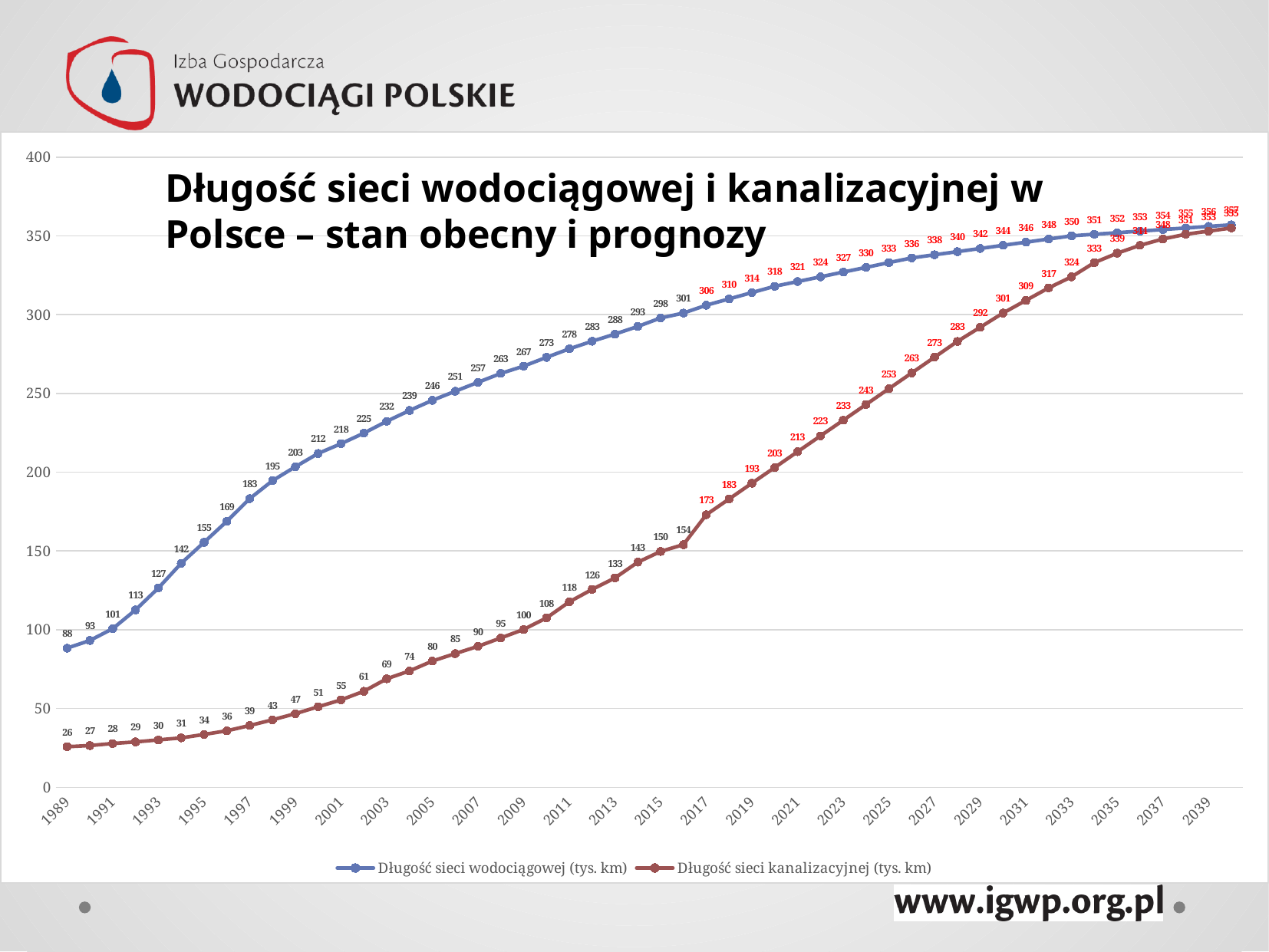
Do the values of Długość sieci kanalizacyjnej rise or fall from 1989 to 2039? rise What is the value of Długość sieci kanalizacyjnej (tys. km) in 1989? 26 What is the value of Długość sieci kanalizacyjnej (tys. km) in 2009? 100 In 2017, which series has the larger value: Długość sieci wodociągowej or Długość sieci kanalizacyjnej? Długość sieci wodociągowej Is the value of Długość sieci wodociągowej in 2039 greater or less than 350? greater How many series does the legend list? 2 In which year is Długość sieci kanalizacyjnej (tys. km) lowest? 1989 What kind of chart is shown on the slide? line chart What is the title of the chart? Długość sieci wodociągowej i kanalizacyjnej w Polsce – stan obecny i prognozy What is the difference between Długość sieci wodociągowej and Długość sieci kanalizacyjnej in 1989? 62 What is the value of Długość sieci wodociągowej (tys. km) in 1989? 88 What is the value of Długość sieci wodociągowej (tys. km) in 2015? 298